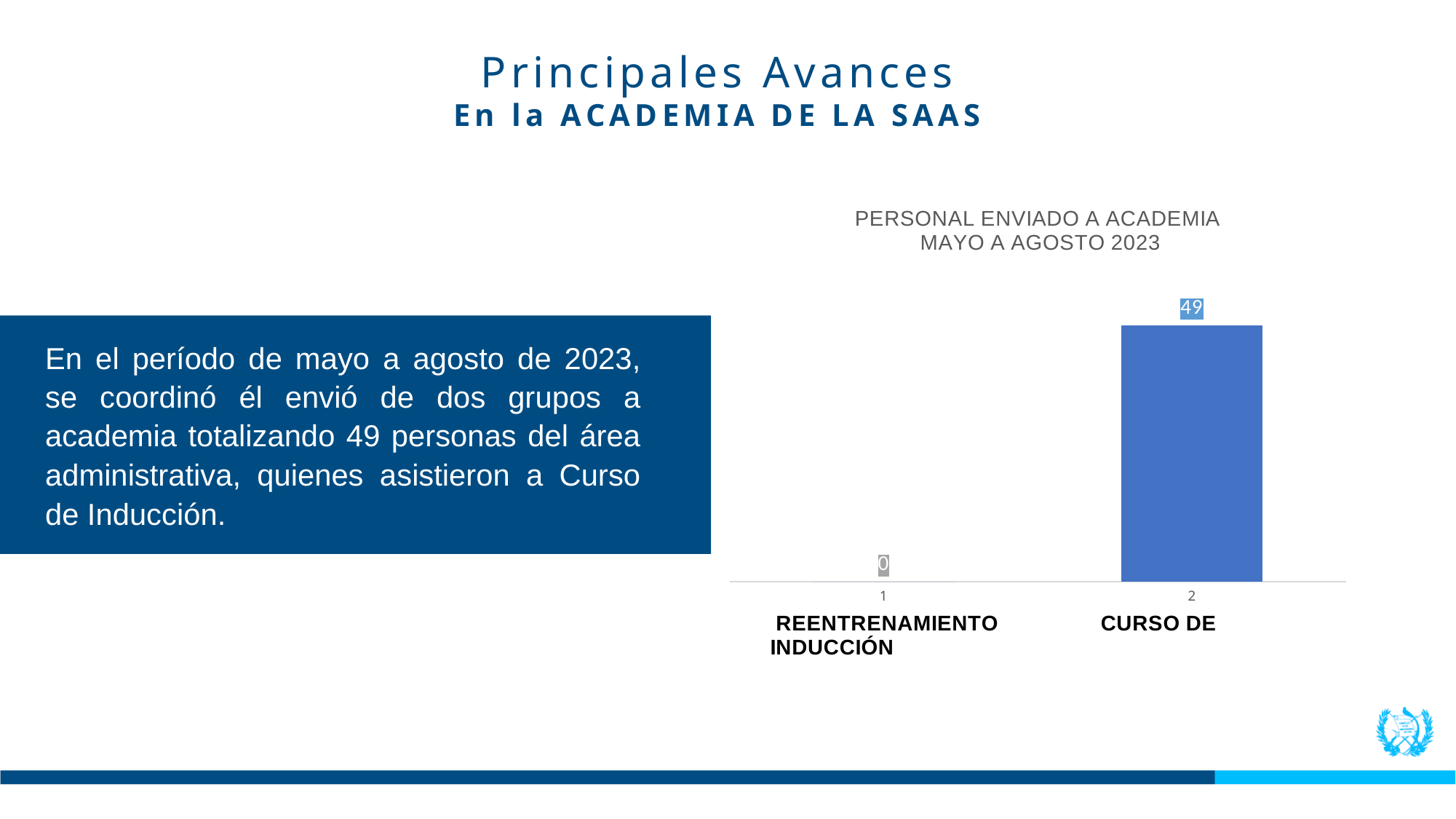
How many categories are plotted in the chart? 2 What is the total of the two values plotted in the chart? 49 What is the value for CURSO DE INDUCCIÓN in the chart? 49 Which is larger, the value for REENTRENAMIENTO or the value for CURSO DE INDUCCIÓN? CURSO DE INDUCCIÓN What is the difference between the values for CURSO DE INDUCCIÓN and REENTRENAMIENTO? 49 What type of chart is shown on the slide? Bar chart What colour is the bar for CURSO DE INDUCCIÓN? Blue Which category has the highest value in the chart? CURSO DE INDUCCIÓN What is the value for REENTRENAMIENTO in the chart? 0 Which category has the lowest value in the chart? REENTRENAMIENTO What is the title of the chart? PERSONAL ENVIADO A ACADEMIA MAYO A AGOSTO 2023